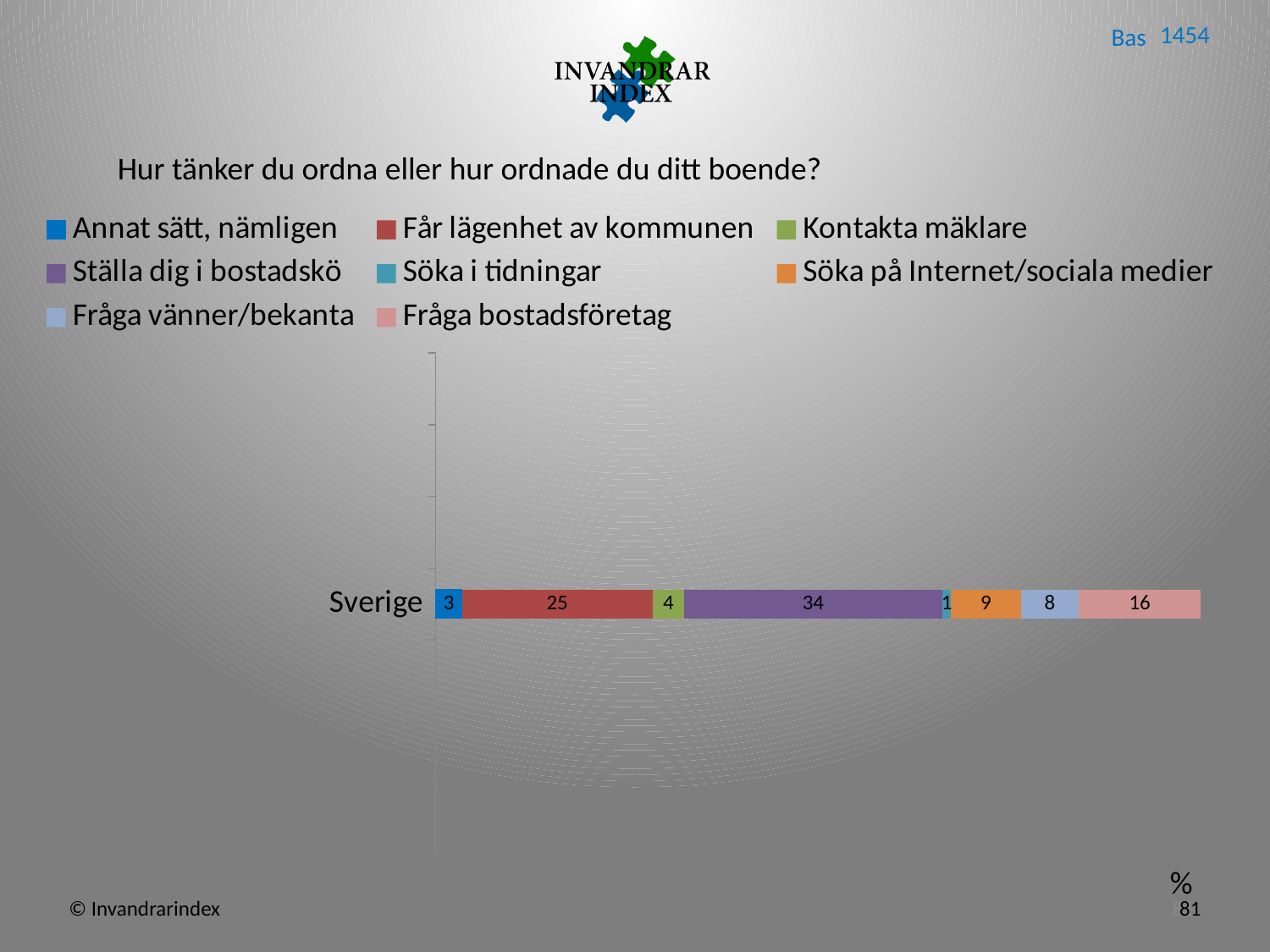
What is the value for 'Söka på Internet/sociala medier' for Sverige? 9 Which series has the highest value for Sverige? Ställa dig i bostadskö What is the value for 'Fråga bostadsföretag' for Sverige? 16 What kind of chart is shown on the slide? Stacked bar chart What is the value for 'Får lägenhet av kommunen' for Sverige? 25 How many categories are plotted on the chart? 1 How many series does the legend list? 8 What is the total of the stacked bar for Sverige? 100 What is the difference between 'Ställa dig i bostadskö' and 'Får lägenhet av kommunen' for Sverige? 9 Which is larger for Sverige: 'Fråga vänner/bekanta' or 'Söka på Internet/sociala medier'? Söka på Internet/sociala medier What is the value for 'Ställa dig i bostadskö' for Sverige? 34 Which series has the lowest value for Sverige? Söka i tidningar